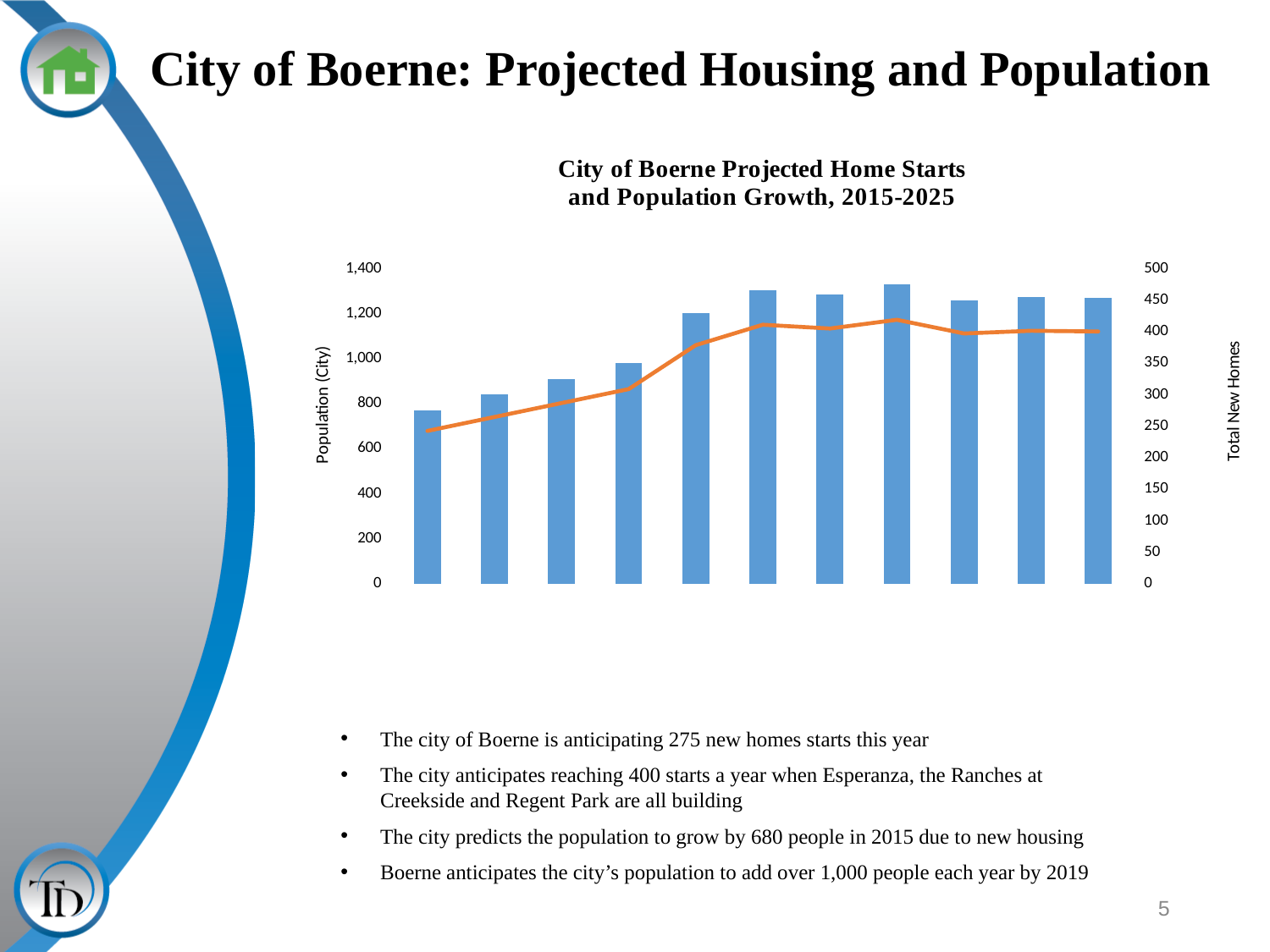
Which is larger, the second bar or the fifth bar? The fifth bar How many bars are plotted in the chart? 11 Which bar in the chart is the lowest? The first (leftmost) bar What is the title of the chart? City of Boerne Projected Home Starts and Population Growth, 2015-2025 What kind of chart is shown on the slide? A combined bar and line chart What is the label on the left vertical axis of the chart? Population (City) Do the bar values generally rise or fall from left to right across the chart? Rise Which is larger, the first bar or the last bar? The last bar